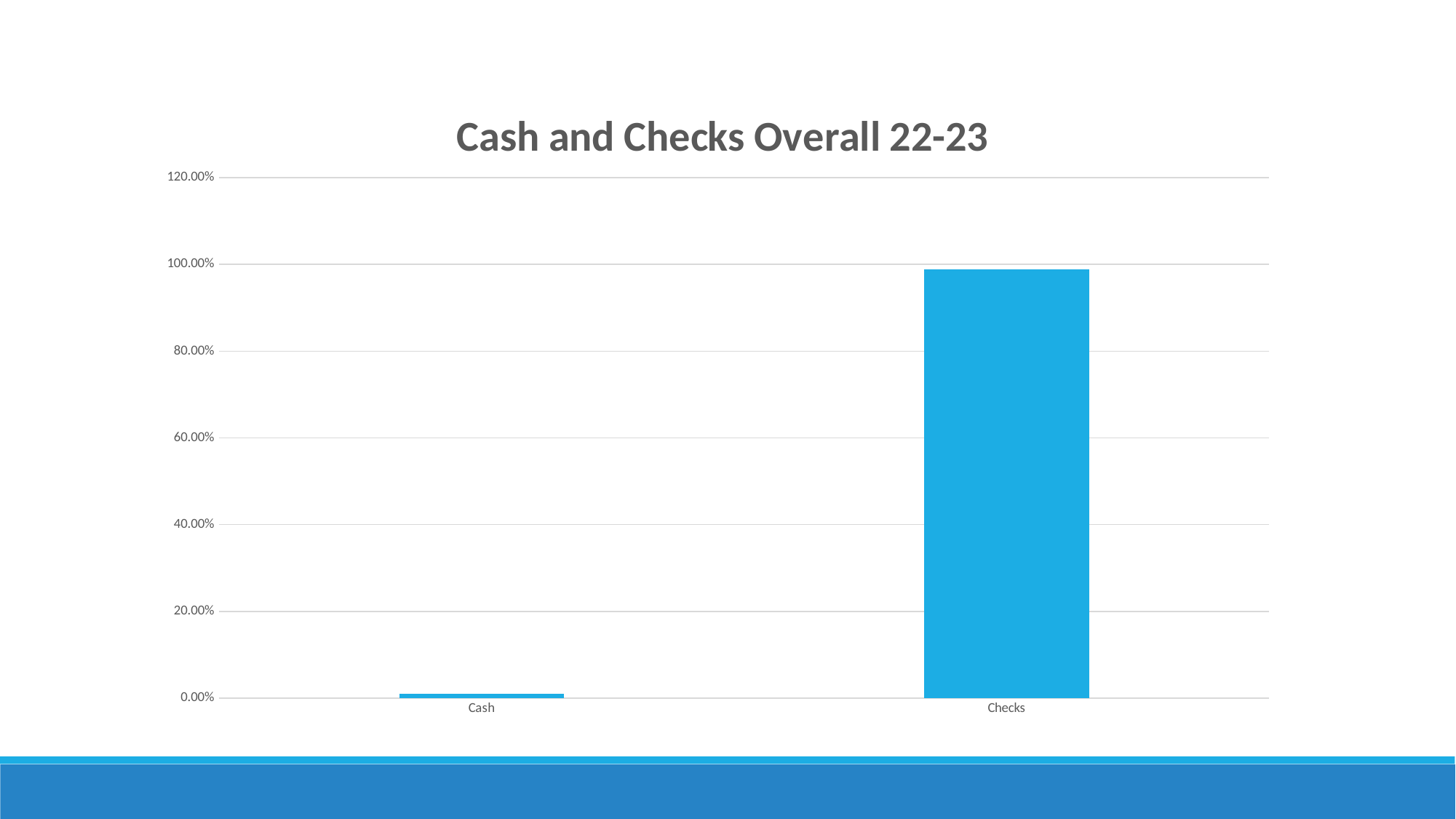
Which is larger, the value for Cash or the value for Checks? Checks Is the value for Cash greater or less than 20.00%? less Which category has the lowest value? Cash Which category has the highest value? Checks What kind of chart is shown on the slide? bar chart What is the highest value shown on the y axis? 120.00% Is the value for Checks greater or less than 80.00%? greater What is the title of the chart? Cash and Checks Overall 22-23 How many categories are shown on the x axis? 2 Is the value for Checks greater or less than 100.00%? less Do the values rise or fall from Cash to Checks along the x axis? rise